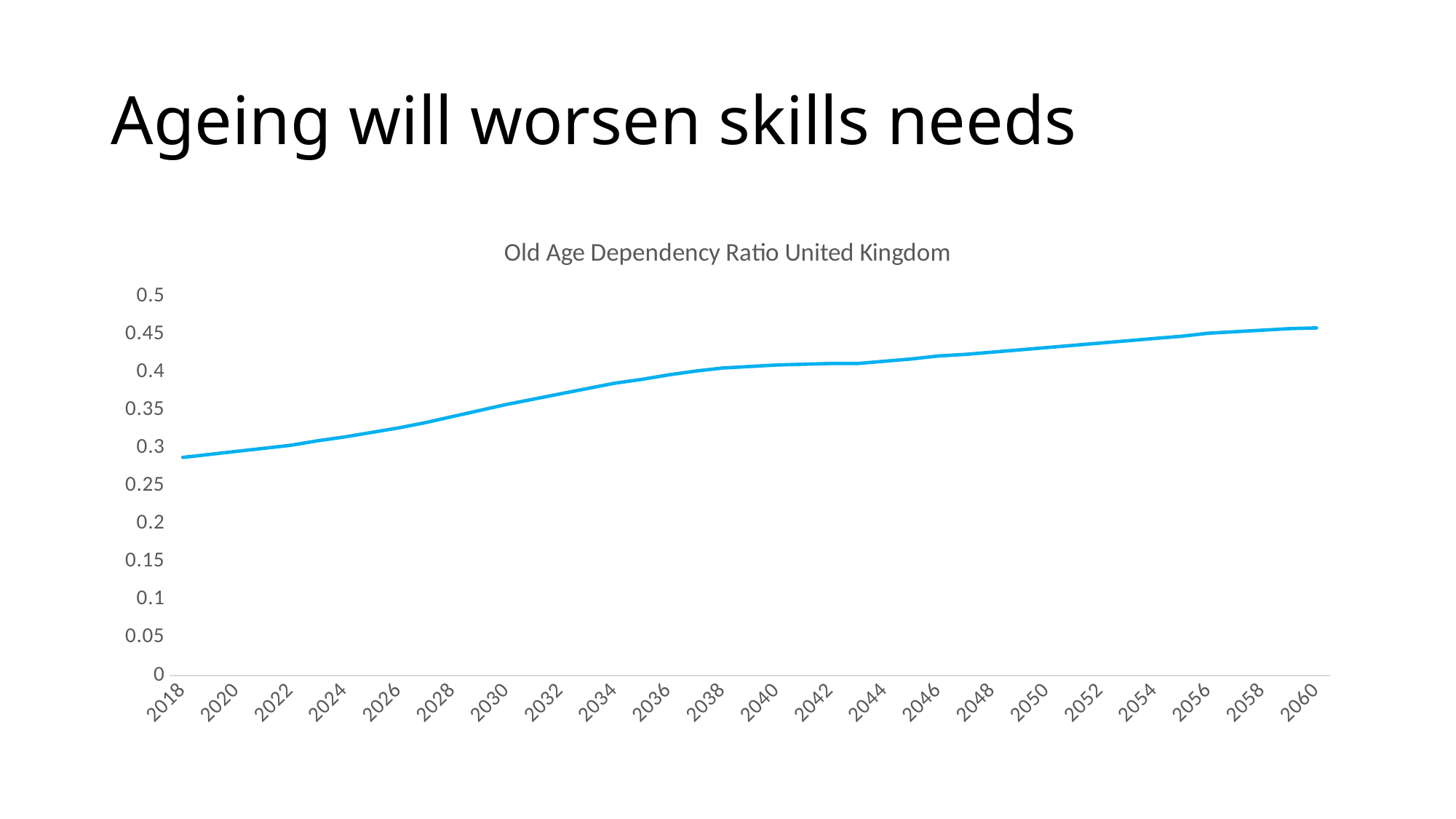
In which year is the old age dependency ratio highest? 2060 Is the value for 2050 greater or less than 0.4? greater What kind of chart is shown on the slide? line chart In which year is the old age dependency ratio lowest? 2018 Is the value for 2024 greater or less than 0.35? less Is the value for 2060 greater or less than 0.4? greater What is the title of the chart? Old Age Dependency Ratio United Kingdom Does the old age dependency ratio rise or fall from 2018 to 2060? rise Which year has the larger old age dependency ratio, 2022 or 2046? 2046